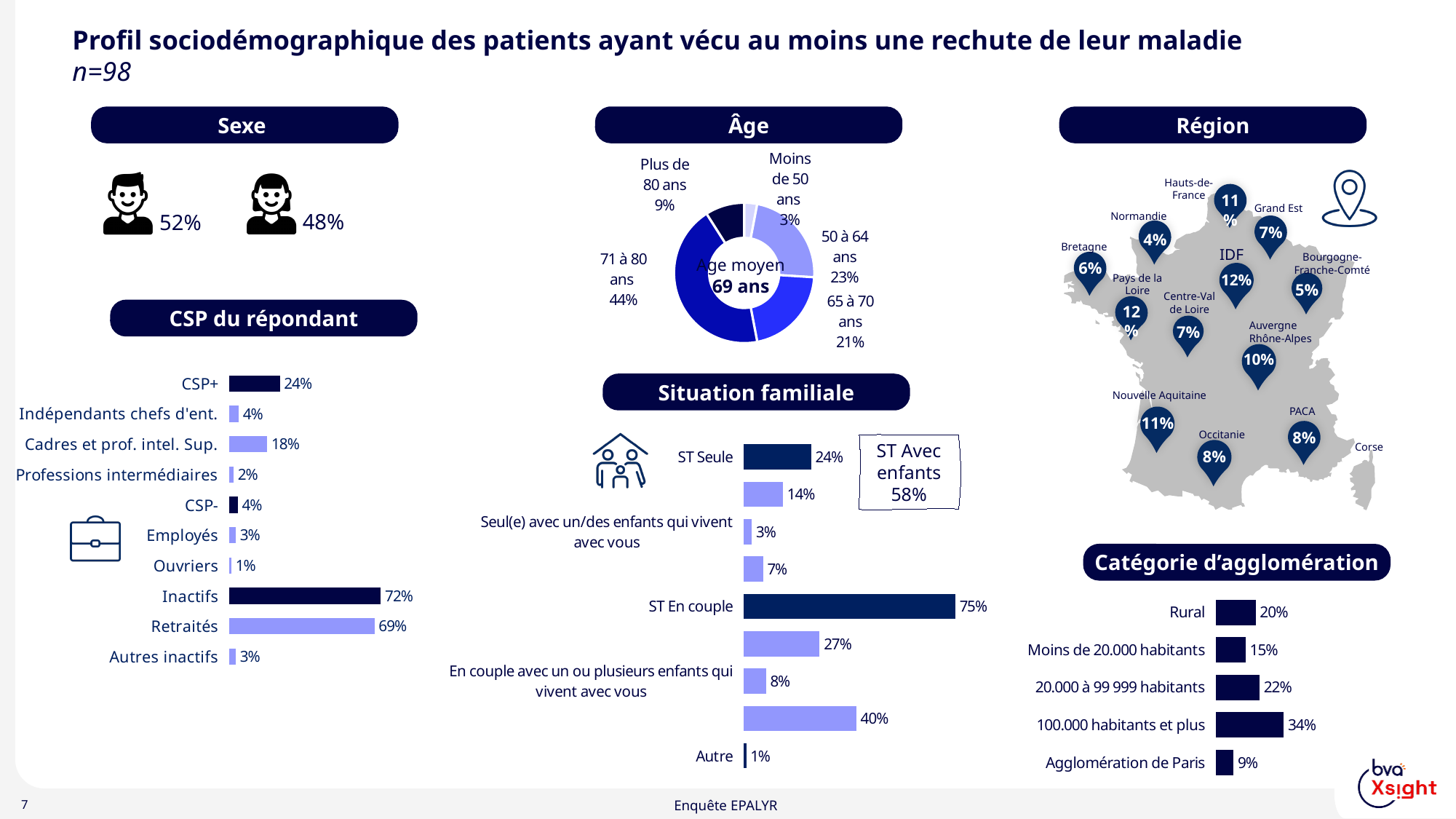
In the 'Situation familiale' chart, what is the value for ST En couple? 75% In the 'Situation familiale' chart, which is larger: ST Seule or ST En couple? ST En couple In the 'CSP du répondant' chart, which category has the lowest value? Ouvriers In the 'Âge' chart, what is the average age shown in the centre? 69 ans In the 'Âge' chart, which age group has the smallest share? Moins de 50 ans In the 'CSP du répondant' chart, what is the difference between Inactifs and Retraités? 3% What kind of chart is the 'Âge' chart? Donut (pie) chart How many categories are shown in the 'Catégorie d'agglomération' chart? 5 In the 'Catégorie d'agglomération' chart, what is the value for Agglomération de Paris? 9% In the 'Catégorie d'agglomération' chart, which category has the highest value? 100.000 habitants et plus In the 'CSP du répondant' chart, what is the value for Inactifs? 72% In the 'Âge' chart, what share of patients are 71 à 80 ans? 44%